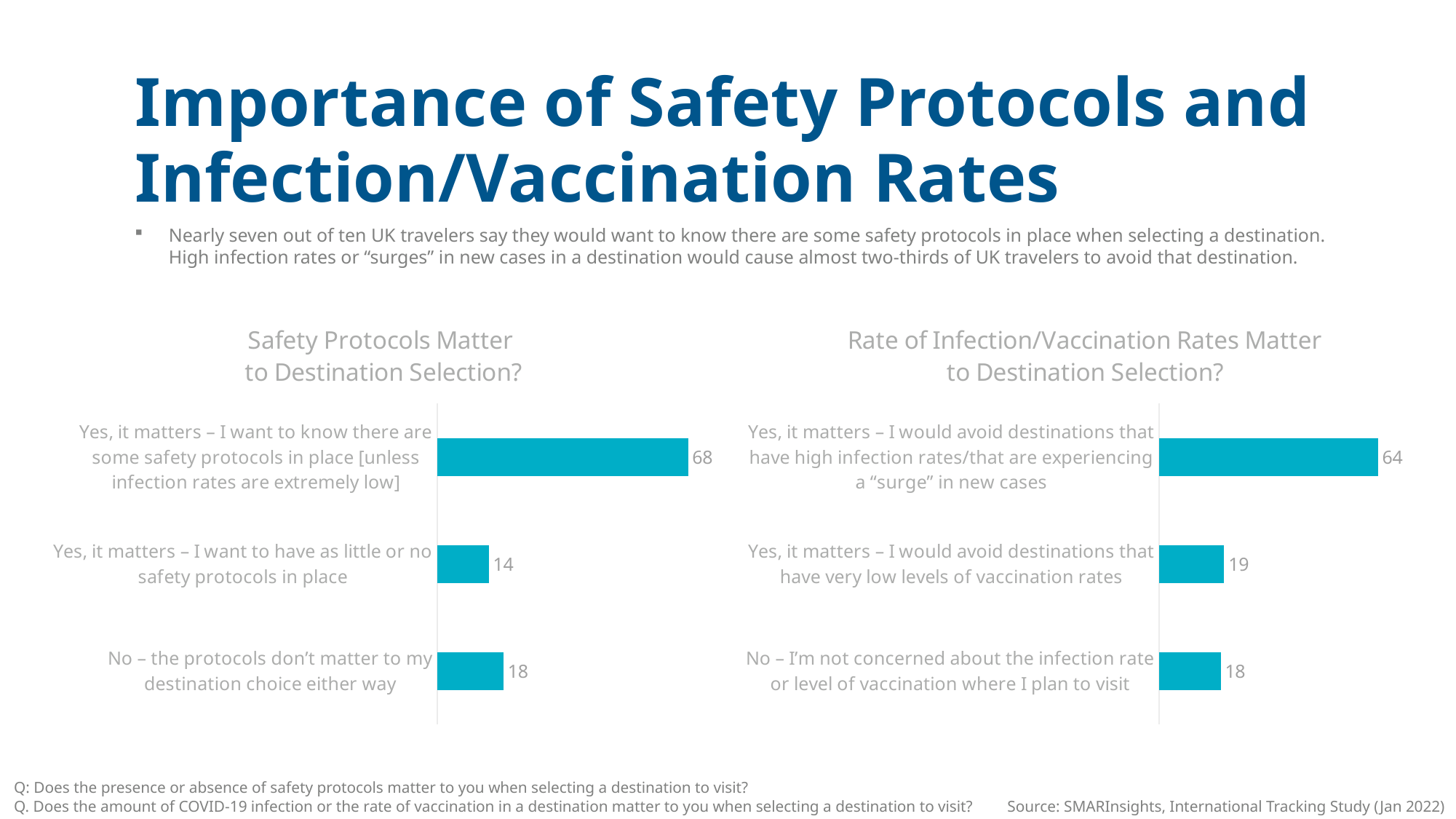
In the 'Rate of Infection/Vaccination Rates Matter to Destination Selection?' chart, what is the difference between the 'avoid destinations with high infection rates' value and the 'avoid destinations with very low vaccination rates' value? 45 How many charts are shown on the slide? 2 How many categories are shown in the 'Rate of Infection/Vaccination Rates Matter to Destination Selection?' chart? 3 In the 'Safety Protocols Matter to Destination Selection?' chart, which category has the lowest value? Yes, it matters – I want to have as little or no safety protocols in place In the 'Safety Protocols Matter to Destination Selection?' chart, which is larger: 'No – the protocols don't matter to my destination choice either way' or 'Yes, it matters – I want to have as little or no safety protocols in place'? No – the protocols don't matter to my destination choice either way What type of chart is the 'Safety Protocols Matter to Destination Selection?' chart? Bar chart Which chart has the higher top value: 'Safety Protocols Matter to Destination Selection?' or 'Rate of Infection/Vaccination Rates Matter to Destination Selection?'? Safety Protocols Matter to Destination Selection? In the 'Rate of Infection/Vaccination Rates Matter to Destination Selection?' chart, what is the value for 'No – I'm not concerned about the infection rate or level of vaccination where I plan to visit'? 18 In the 'Safety Protocols Matter to Destination Selection?' chart, what is the value for 'Yes, it matters – I want to know there are some safety protocols in place'? 68 In the 'Safety Protocols Matter to Destination Selection?' chart, what is the difference between the 'Yes, I want to know there are some safety protocols in place' value and the 'No – the protocols don't matter' value? 50 In the 'Rate of Infection/Vaccination Rates Matter to Destination Selection?' chart, what is the value for 'Yes, it matters – I would avoid destinations that have very low levels of vaccination rates'? 19 In the 'Rate of Infection/Vaccination Rates Matter to Destination Selection?' chart, which category has the highest value? Yes, it matters – I would avoid destinations that have high infection rates/that are experiencing a "surge" in new cases